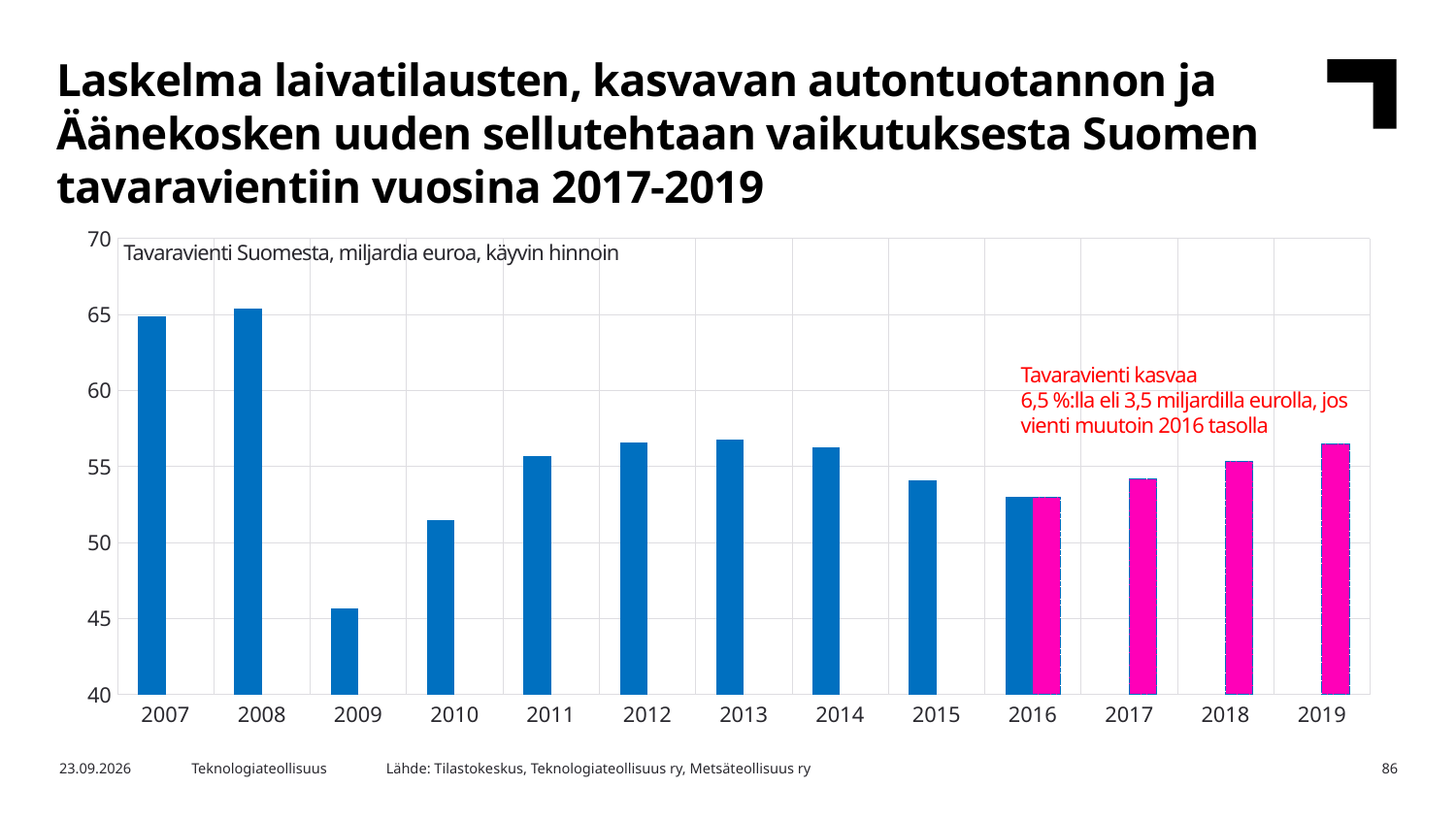
Which year has the larger value, 2010 or 2011? 2011 What text is shown inside the chart area at the top left describing the data? Tavaravienti Suomesta, miljardia euroa, käyvin hinnoin What kind of chart is shown on the slide? Bar chart Do the values rise or fall from 2016 to 2019? Rise Is the value for 2009 greater or less than 50? less How many years are shown on the x axis of the chart? 13 Which year has the highest value in the chart? 2008 Is the value for 2019 greater or less than 55? greater Which year has the lowest value in the chart? 2009 Is the value for 2007 greater or less than 60? greater Which year has the larger value, 2009 or 2015? 2015